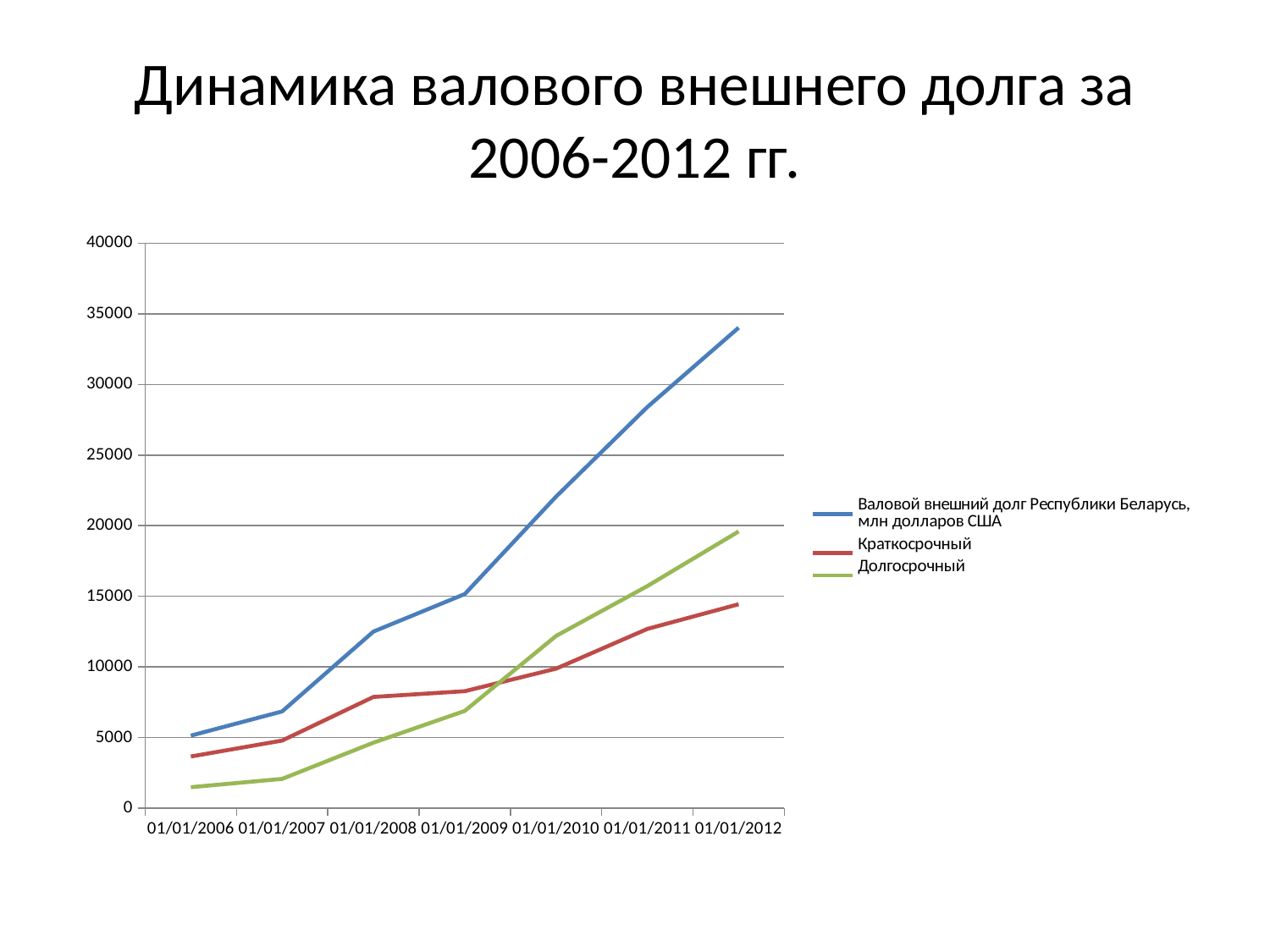
On which date is the value for Долгосрочный lowest? 01/01/2006 On 01/01/2012, which is larger: Краткосрочный or Долгосрочный? Долгосрочный How many dates are shown on the x axis? 7 How many series does the legend list? 3 Is the value for Долгосрочный on 01/01/2006 greater or less than 5000? less On which date is the value for Валовой внешний долг Республики Беларусь highest? 01/01/2012 Is the value for Валовой внешний долг Республики Беларусь on 01/01/2012 greater or less than 30000? greater What kind of chart is shown on the slide? line chart Is the value for Краткосрочный on 01/01/2012 greater or less than 15000? less Does the value for Валовой внешний долг Республики Беларусь rise or fall from 01/01/2006 to 01/01/2012? rise On 01/01/2008, which is larger: Краткосрочный or Долгосрочный? Краткосрочный